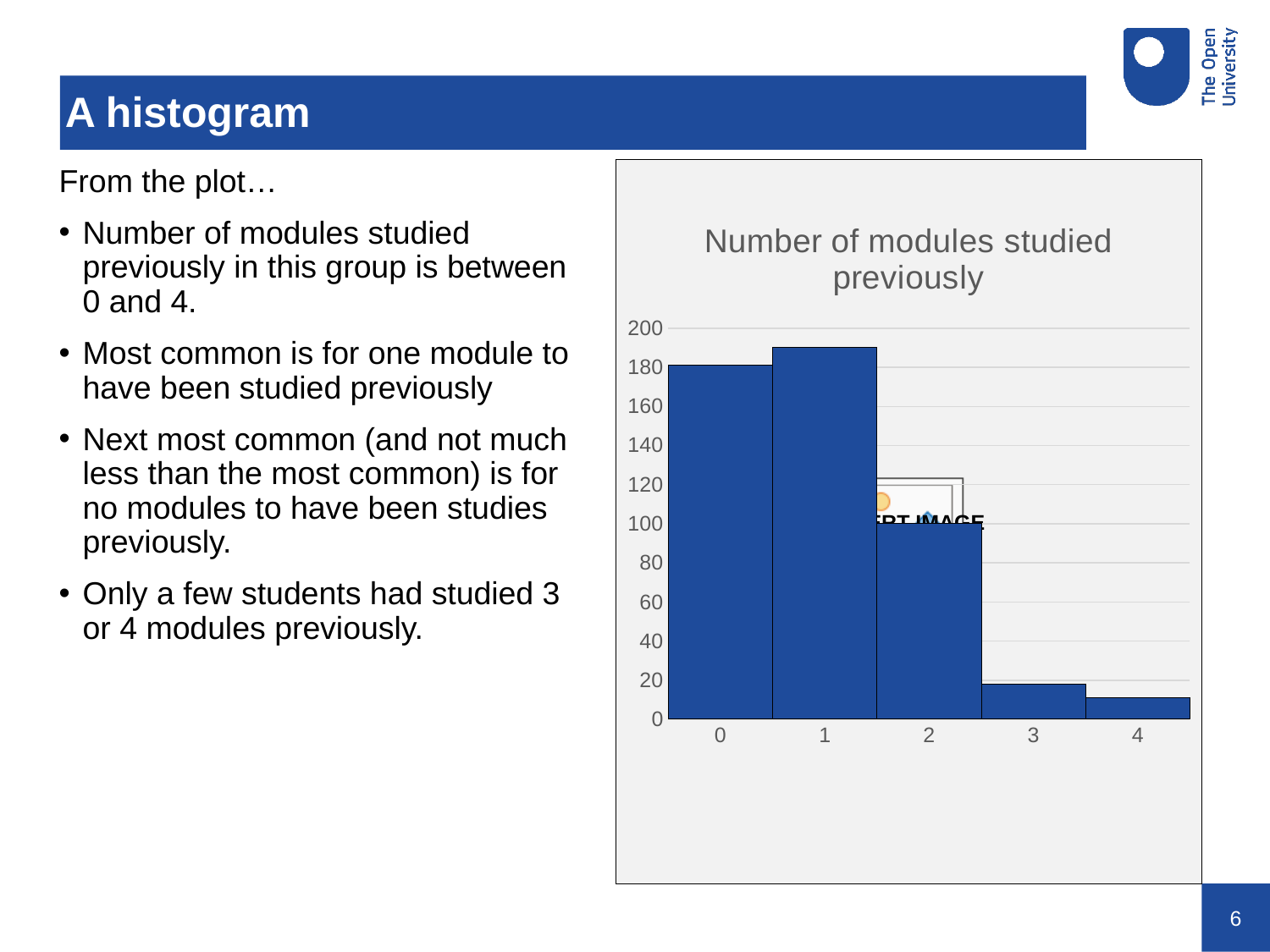
Which number of modules studied previously has the tallest bar? 1 Is the value for 1 module greater or less than 180? greater What kind of chart is shown on the slide? bar chart (histogram) Do the bar heights rise or fall from 1 module to 4 modules along the x axis? fall Which bar is taller, the one for 2 modules or the one for 3 modules? 2 What is the title of the chart? Number of modules studied previously Is the value for 2 modules greater or less than 120? less Is the value for 3 modules greater or less than 40? less Which bar is taller, the one for 0 modules or the one for 1 module? 1 Which number of modules studied previously has the shortest bar? 4 How many bars (categories) does the chart show? 5